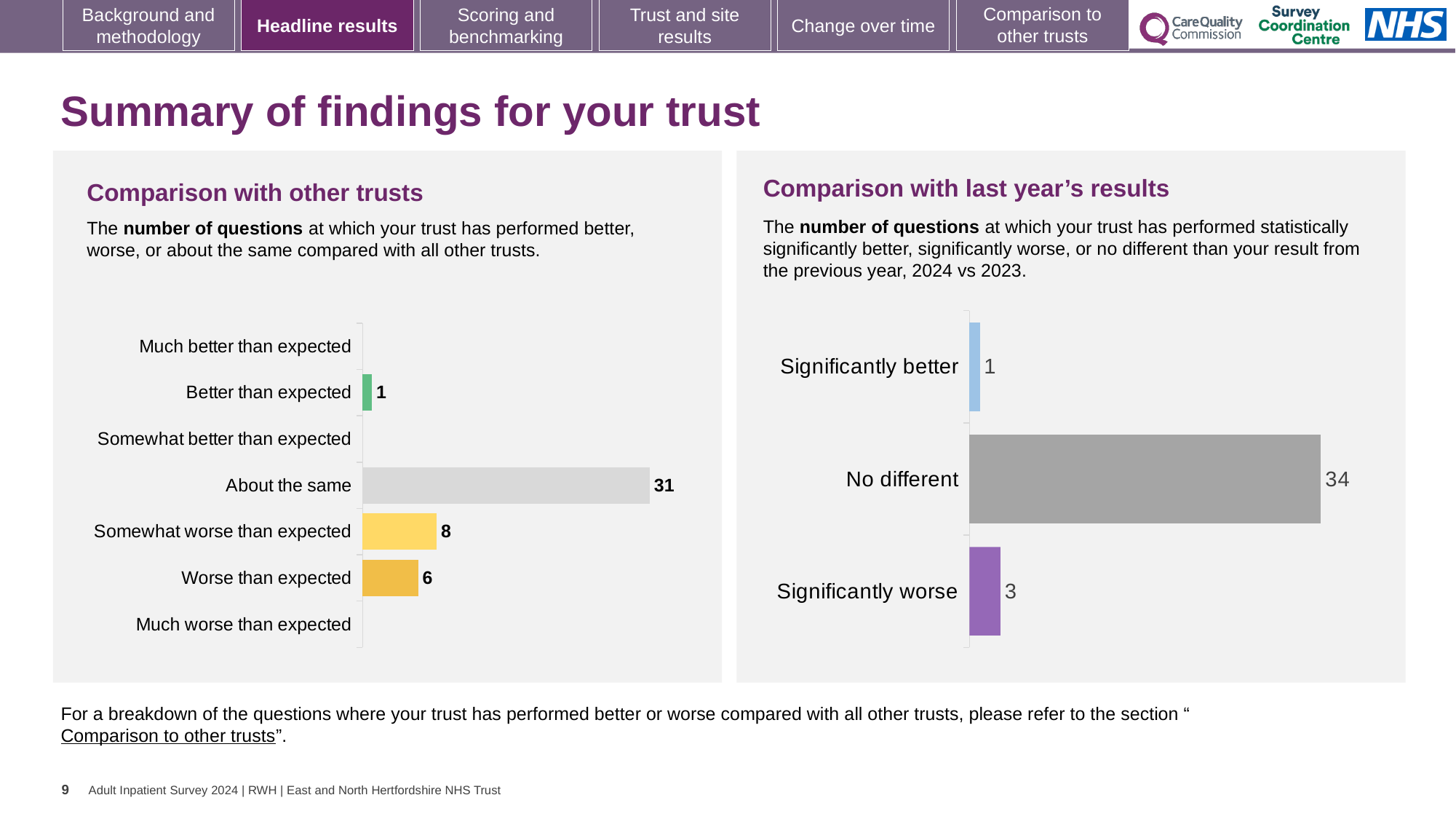
In the 'Comparison with last year's results' chart, what is the difference between 'No different' and 'Significantly worse'? 31 In the 'Comparison with last year's results' chart, what is the value for 'Significantly worse'? 3 In the 'Comparison with last year's results' chart, which category has the lowest value? Significantly better In the 'Comparison with last year's results' chart, which is larger: 'Significantly better' or 'Significantly worse'? Significantly worse In the 'Comparison with other trusts' chart, what is the value for 'About the same'? 31 What kind of chart is the 'Comparison with last year's results' chart? Bar chart In the 'Comparison with other trusts' chart, what is the value for 'Worse than expected'? 6 In the 'Comparison with other trusts' chart, what is the value for 'Somewhat worse than expected'? 8 In the 'Comparison with other trusts' chart, how many categories are listed on the axis? 7 In the 'Comparison with last year's results' chart, what is the value for 'No different'? 34 In the 'Comparison with other trusts' chart, which category has the highest value? About the same In the 'Comparison with other trusts' chart, what is the difference between 'Somewhat worse than expected' and 'Worse than expected'? 2